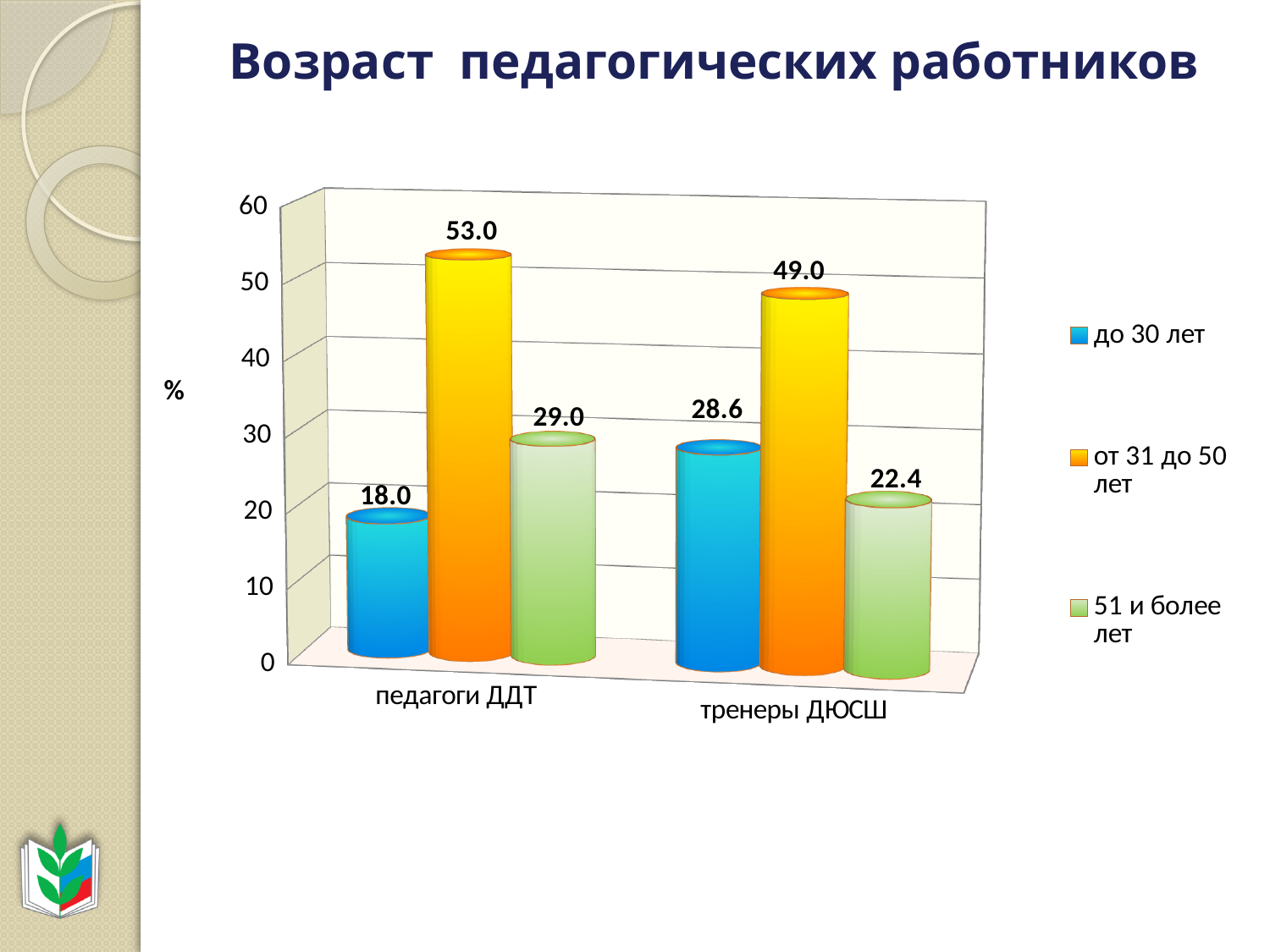
What is the value for 'до 30 лет' in the 'педагоги ДДТ' category? 18.0 What is the value for 'от 31 до 50 лет' in the 'тренеры ДЮСШ' category? 49.0 How many series does the legend list? 3 Which is larger: the 'до 30 лет' value for 'педагоги ДДТ' or for 'тренеры ДЮСШ'? тренеры ДЮСШ Which age group has the lowest value among 'тренеры ДЮСШ'? 51 и более лет What is the title of the chart? Возраст педагогических работников Is the value for '51 и более лет' among 'тренеры ДЮСШ' greater or less than 30? less What is the difference between the 'от 31 до 50 лет' values for 'педагоги ДДТ' and 'тренеры ДЮСШ'? 4.0 Which age group has the highest value among 'педагоги ДДТ'? от 31 до 50 лет What is the value for '51 и более лет' in the 'педагоги ДДТ' category? 29.0 What kind of chart is shown on the slide? bar chart How many categories are shown on the x axis? 2